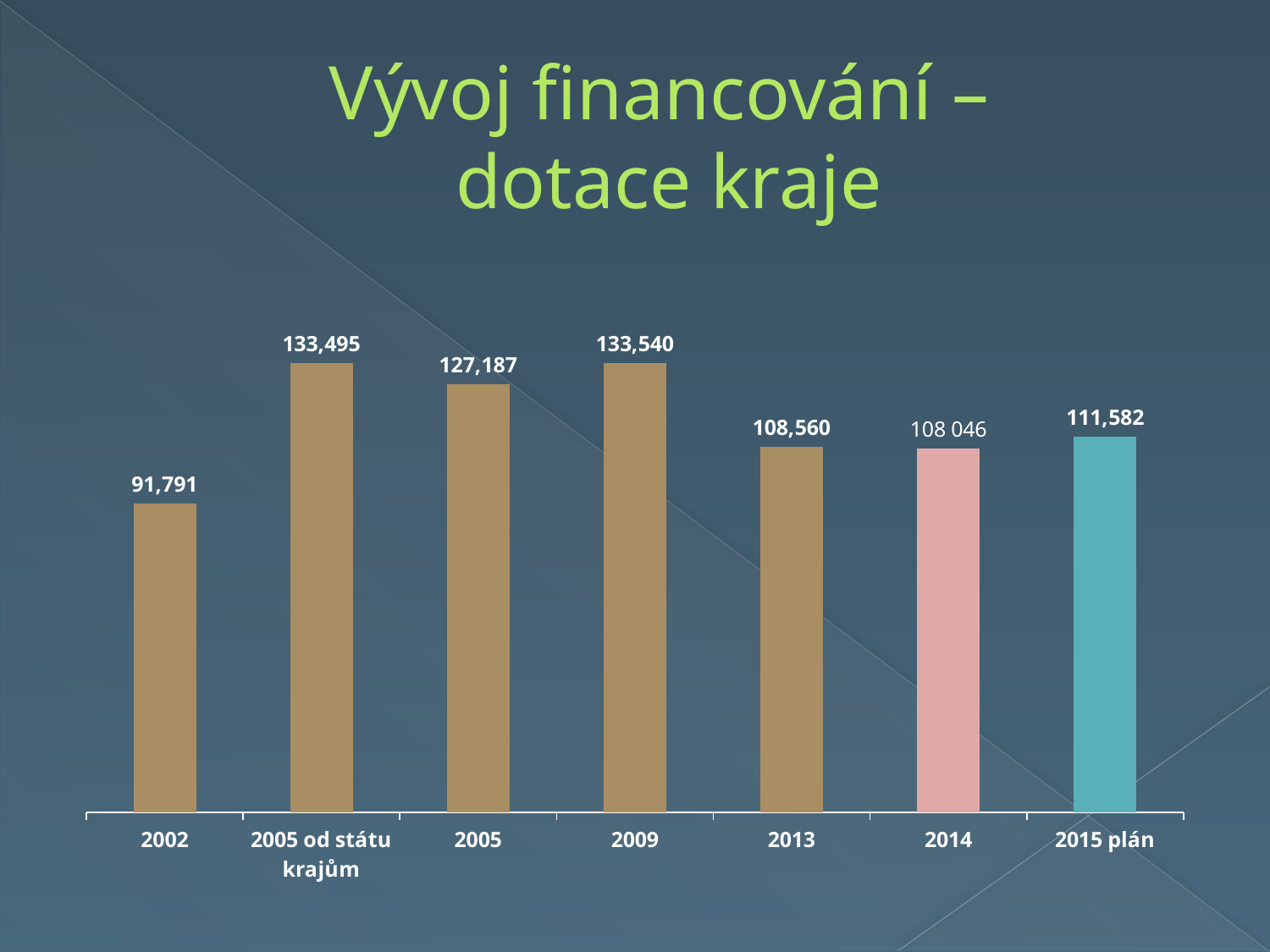
What is the title of the slide? Vývoj financování – dotace kraje Which is larger, the value for 2005 or the value for 2013? 2005 What is the value for 2009? 133,540 What is the value for 2005 od státu krajům? 133,495 How many categories are shown on the x axis? 7 What is the value for 2002? 91,791 What is the value for 2015 plán? 111,582 What is the difference between the values for 2015 plán and 2013? 3,022 What is the value for 2014? 108 046 Which category has the lowest value? 2002 What is the difference between the values for 2005 od státu krajům and 2005? 6,308 What kind of chart is shown on the slide? Bar chart